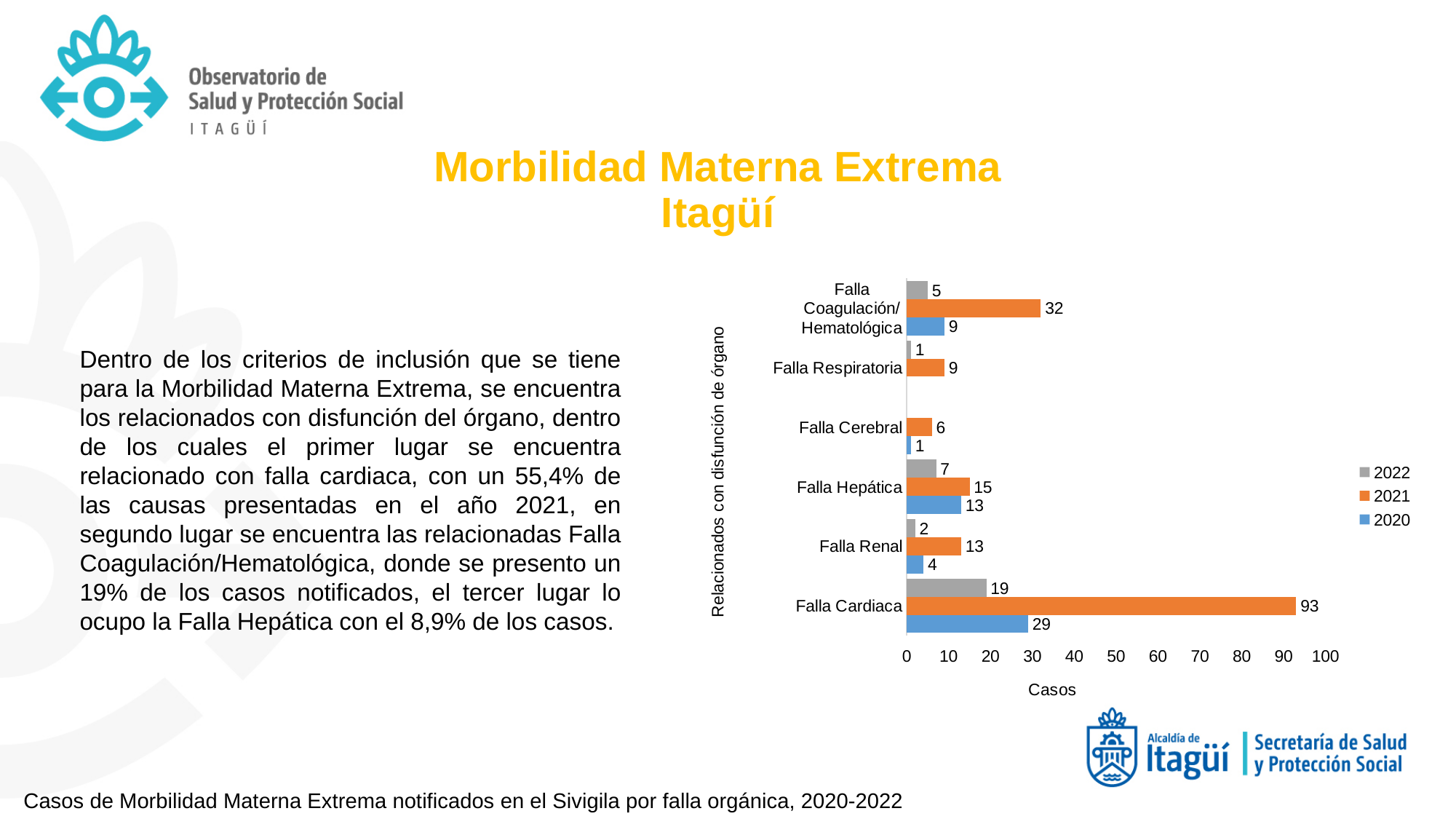
What kind of chart is shown on the slide? Bar chart What is the label of the x axis? Casos Which is larger for Falla Renal, the 2021 value or the 2020 value? 2021 Which category has the lowest value in 2022 among those with a labelled 2022 bar? Falla Respiratoria Which category has the highest value in 2021? Falla Cardiaca How many categories of organ dysfunction are shown on the y axis? 6 What is the value for Falla Coagulación/Hematológica in 2020? 9 What is the value for Falla Hepática in 2022? 7 Which colour represents the 2021 series in the legend? Orange What is the value for Falla Cardiaca in 2021? 93 What is the difference between the 2021 and 2020 values for Falla Cardiaca? 64 How many series does the legend list? 3